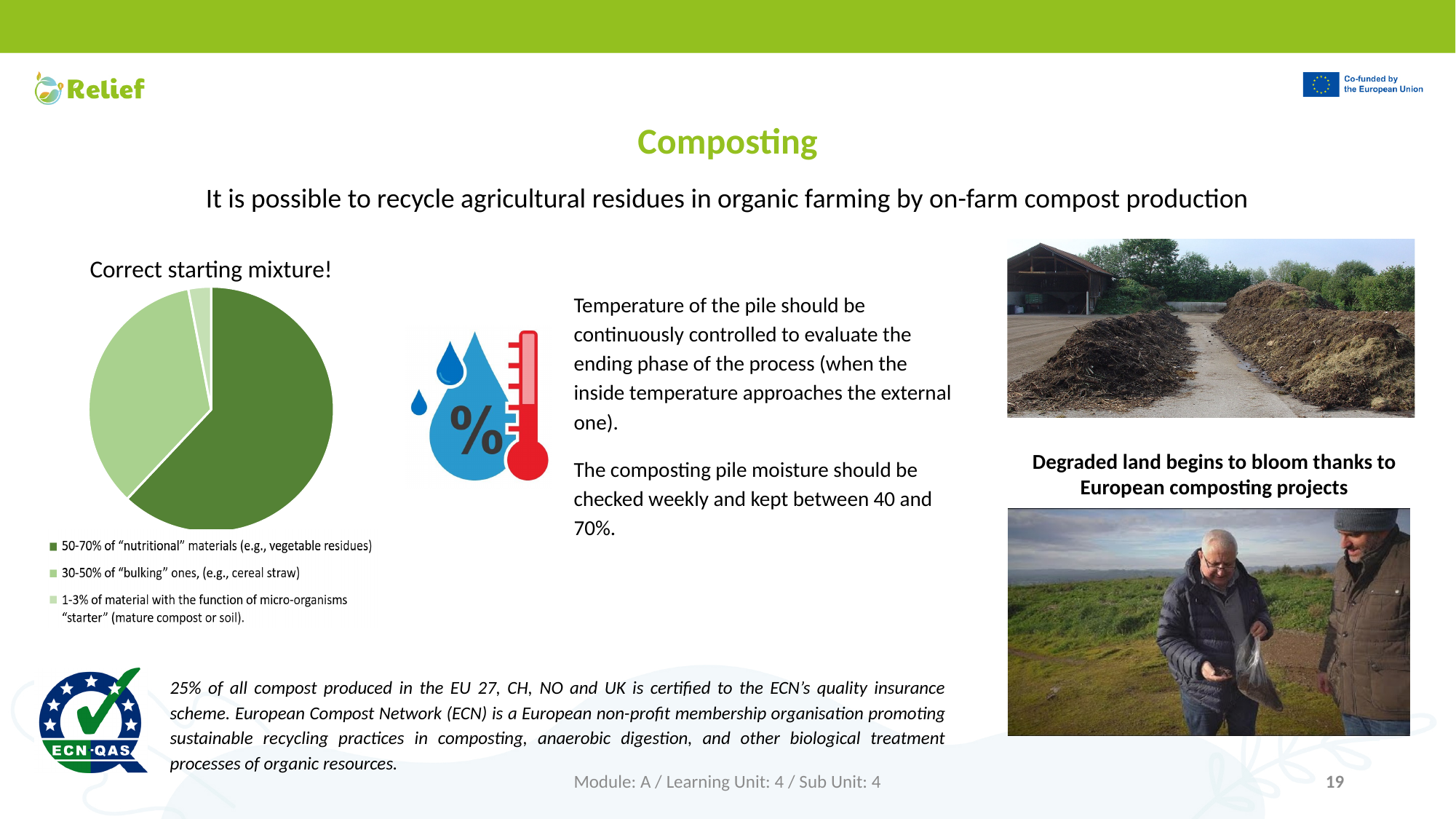
In the "Correct starting mixture!" pie chart, which slice is larger: the "bulking" ones or the micro-organisms "starter" material? "bulking" ones In the "Correct starting mixture!" pie chart, which slice is larger: the "nutritional" materials or the "bulking" ones? "nutritional" materials How many slices does the "Correct starting mixture!" pie chart have? 3 How many entries does the legend of the "Correct starting mixture!" pie chart list? 3 What colour is the slice for the "nutritional" materials in the pie chart? Dark green What is the title shown above the pie chart? Correct starting mixture! Which category takes the largest slice of the "Correct starting mixture!" pie chart? 50-70% of "nutritional" materials (e.g., vegetable residues) Which category takes the smallest slice of the "Correct starting mixture!" pie chart? 1-3% of material with the function of micro-organisms "starter" (mature compost or soil) What kind of chart is shown under the heading "Correct starting mixture!"? Pie chart